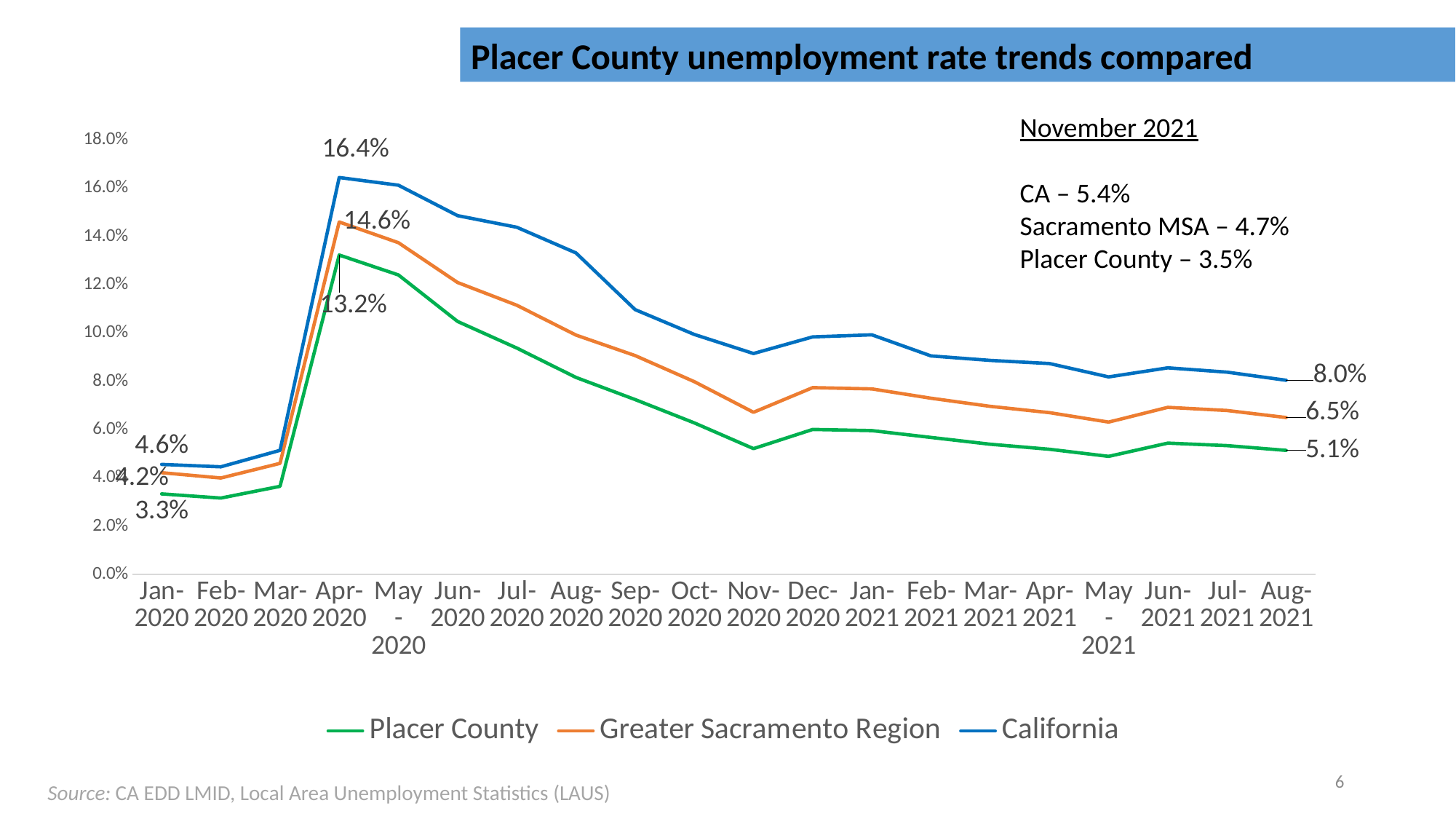
In which month did the Placer County line reach its highest value? Apr-2020 What was Placer County's unemployment rate in Jan-2020? 3.3% How many months are shown on the x axis? 20 What is the difference between California's and Placer County's unemployment rates in Aug-2021? 2.9% Which series had the higher unemployment rate in Aug-2021, California or Greater Sacramento Region? California How many series does the legend list? 3 What was California's unemployment rate in Apr-2020? 16.4% What was the Greater Sacramento Region unemployment rate in Apr-2020? 14.6% Is the Placer County value for Nov-2020 greater or less than 6.0%? less What type of chart is shown on the slide? line chart What was Placer County's unemployment rate in Aug-2021? 5.1% What is the difference between California's and Placer County's unemployment rates in Apr-2020? 3.2%